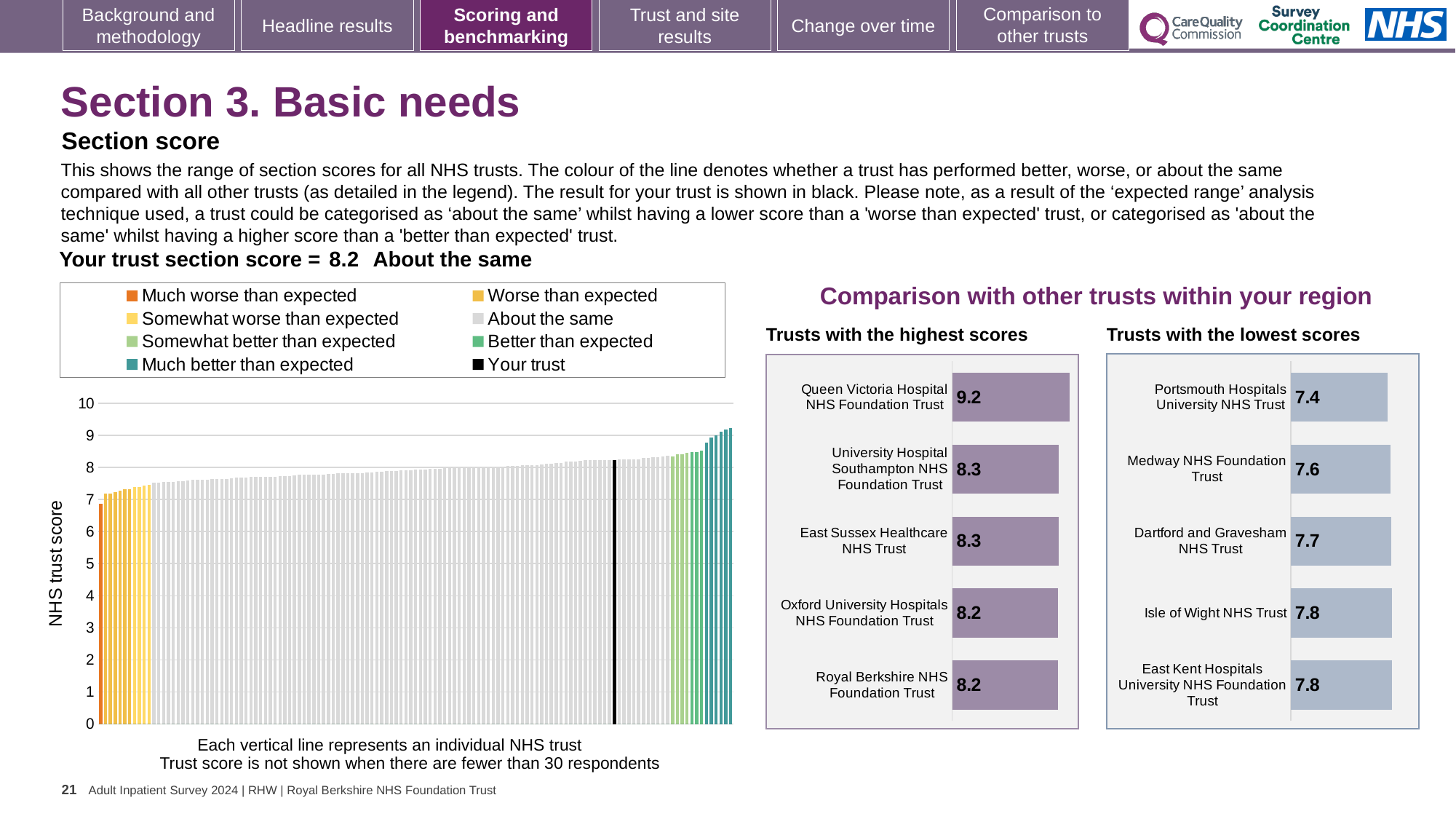
In the 'Trusts with the highest scores' chart, which trust has the highest score? Queen Victoria Hospital NHS Foundation Trust In the 'Trusts with the lowest scores' chart, which has the larger score: Dartford and Gravesham NHS Trust or Medway NHS Foundation Trust? Dartford and Gravesham NHS Trust In the 'Trusts with the lowest scores' chart, what is the difference between the scores of Medway NHS Foundation Trust and Portsmouth Hospitals University NHS Trust? 0.2 In the NHS trust score chart on the left, do the values rise or fall from left to right? Rise What kind of chart is the NHS trust score chart on the left of the slide? Bar chart In the 'Trusts with the highest scores' chart, what is the score for Queen Victoria Hospital NHS Foundation Trust? 9.2 In the 'Trusts with the lowest scores' chart, what is the score for East Kent Hospitals University NHS Foundation Trust? 7.8 In the 'Trusts with the lowest scores' chart, which trust has the lowest score? Portsmouth Hospitals University NHS Trust In the 'Trusts with the highest scores' chart, how many trusts are shown? 5 In the 'Trusts with the lowest scores' chart, what is the score for Portsmouth Hospitals University NHS Trust? 7.4 In the 'Trusts with the highest scores' chart, what is the difference between the scores of Queen Victoria Hospital NHS Foundation Trust and Royal Berkshire NHS Foundation Trust? 1.0 How many entries does the legend of the NHS trust score chart on the left list? 8